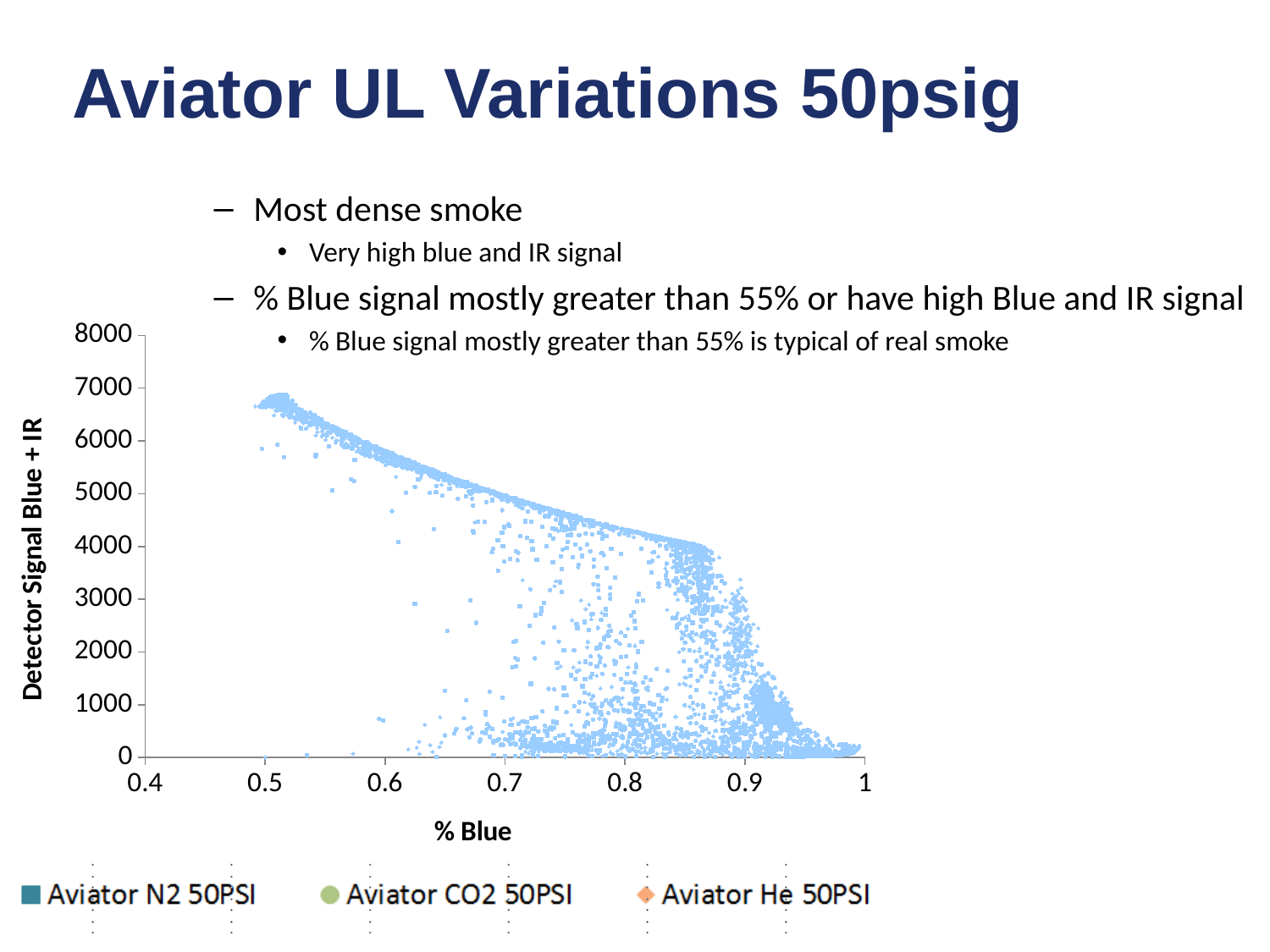
How many series does the legend list? 3 What kind of chart is shown on the slide? scatter chart Are the detector signal values of the points at % Blue = 0.9 greater or less than 4000? less What are the three series named in the legend? Aviator N2 50PSI, Aviator CO2 50PSI, Aviator He 50PSI As % Blue increases along the x axis, do the detector signal values generally rise or fall? fall Is the highest plotted detector signal greater or less than 8000? less Are the detector signal values of the points near % Blue = 1 greater or less than 1000? less What is the title of the vertical axis? Detector Signal Blue + IR